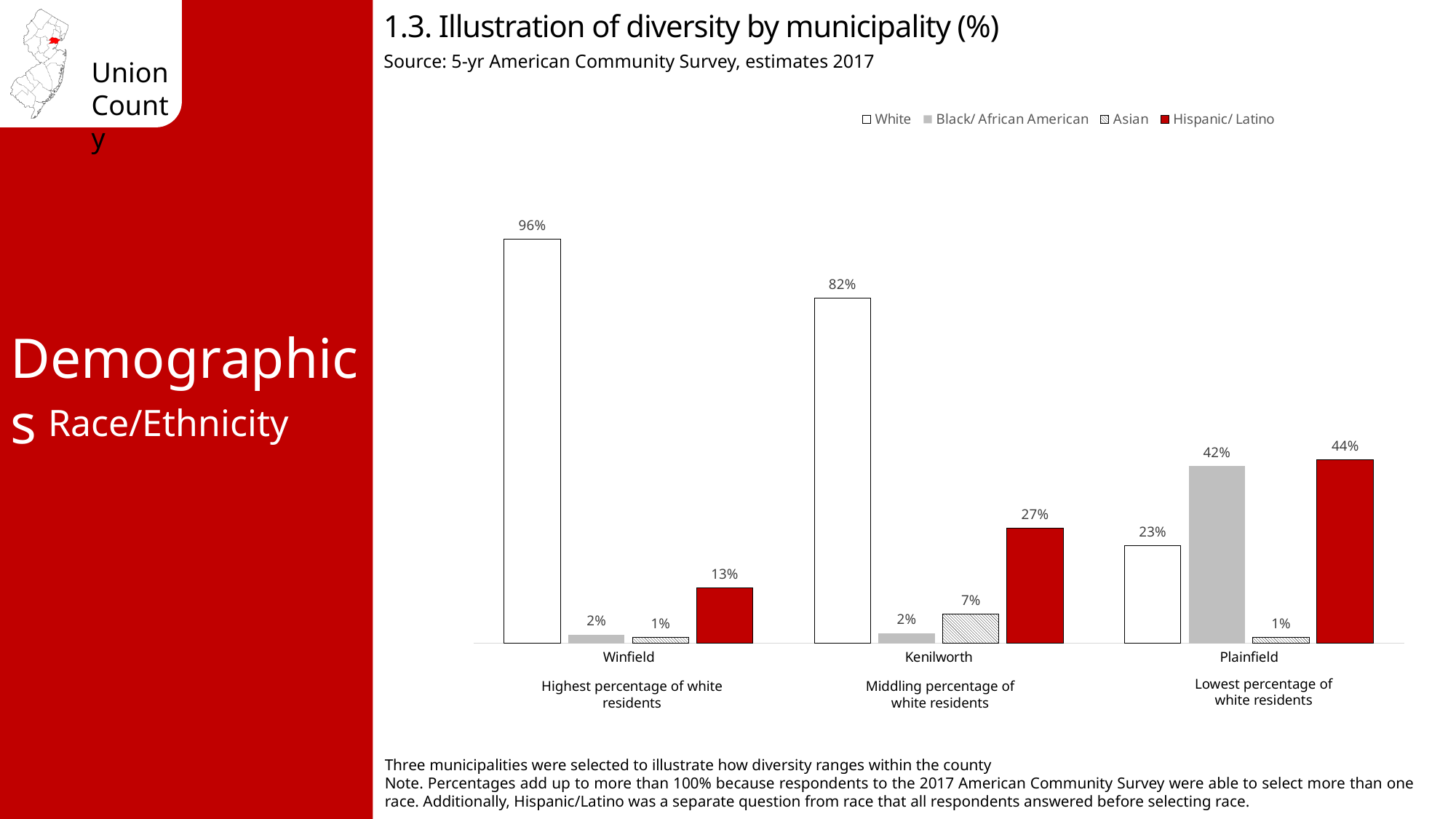
Which municipality has the lowest Hispanic/ Latino percentage? Winfield What is the Asian percentage for Kenilworth? 7% What is the White percentage for Winfield? 96% What is the Hispanic/ Latino percentage for Plainfield? 44% What is the Black/ African American percentage for Plainfield? 42% How many municipalities are shown on the chart? 3 What is the difference between the White percentages for Winfield and Kenilworth? 14% How many series does the legend list? 4 Which is larger for Plainfield: the White percentage or the Black/ African American percentage? Black/ African American What kind of chart is shown on the slide? Bar chart Which municipality has the highest White percentage? Winfield What is the difference between the Hispanic/ Latino percentages for Plainfield and Kenilworth? 17%